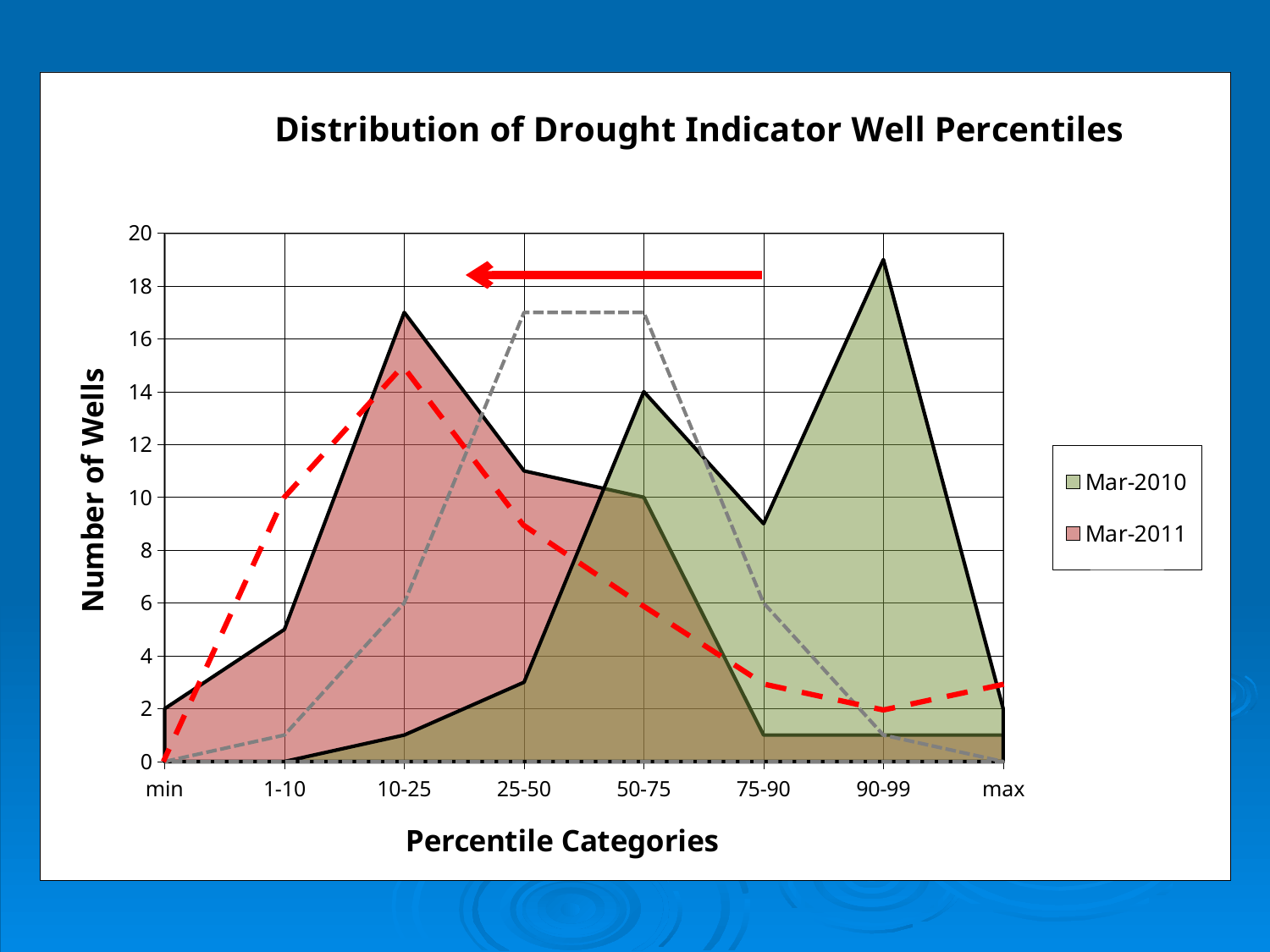
In which percentile category does the Mar-2011 series reach its highest number of wells? 10-25 Is the number of wells for Mar-2010 in the 10-25 category greater or less than 2? less Which series has more wells in the 10-25 percentile category, Mar-2010 or Mar-2011? Mar-2011 How many percentile categories are shown on the x axis? 8 How many series does the legend list? 2 What is the label of the y axis? Number of Wells What is the title of the chart? Distribution of Drought Indicator Well Percentiles What type of chart is shown on the slide? Area chart Is the number of wells for Mar-2011 in the 10-25 category greater or less than 16? greater In which percentile category does the Mar-2010 series reach its highest number of wells? 90-99 Is the number of wells for Mar-2010 in the 90-99 category greater or less than 18? greater Which series has more wells in the 90-99 percentile category, Mar-2010 or Mar-2011? Mar-2010